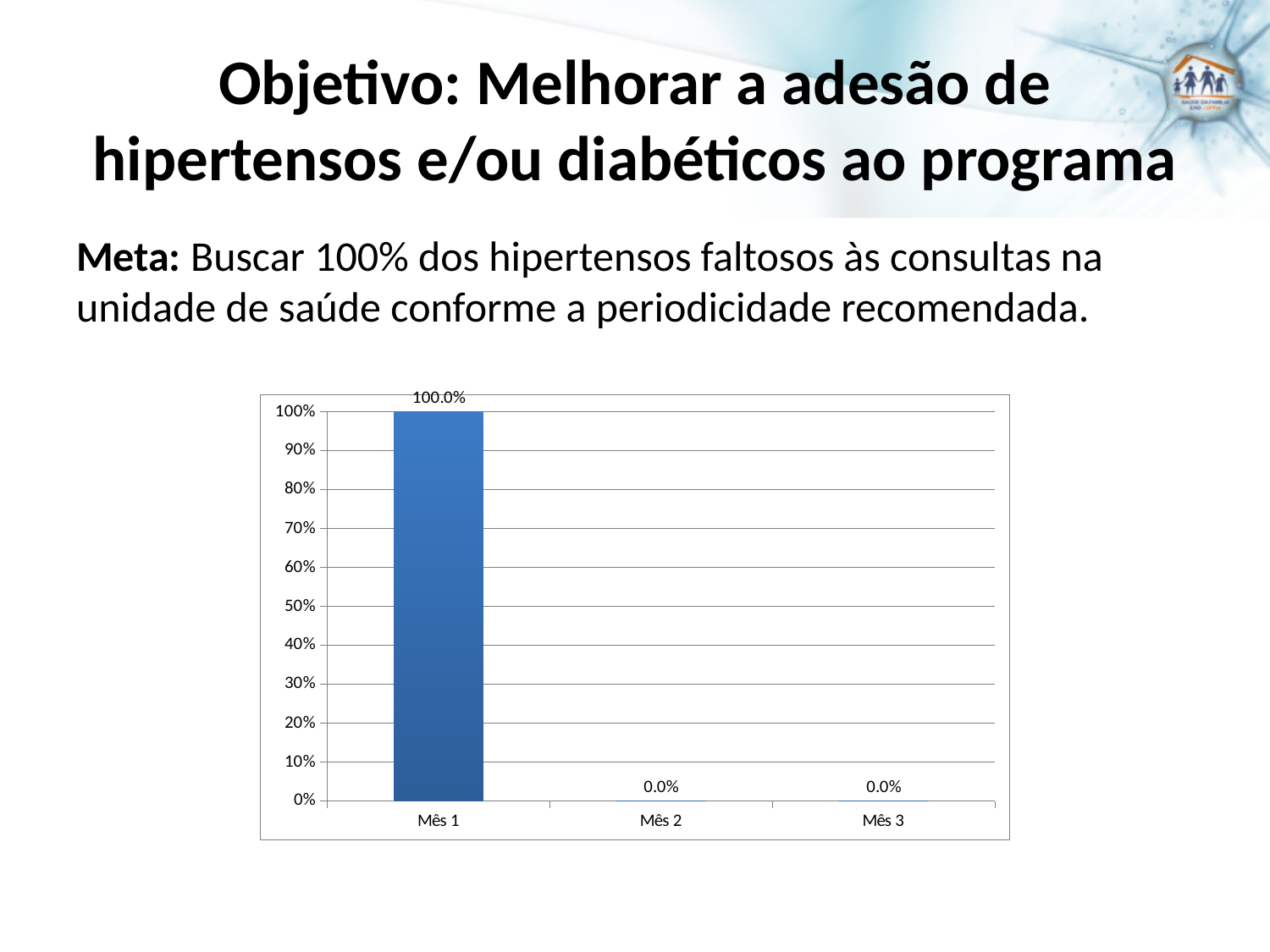
Do the values rise or fall from Mês 1 to Mês 3? fall Is the value for Mês 1 greater or less than 50%? greater What kind of chart is shown on the slide? bar chart What is the highest value shown on the y axis? 100% What is the value for Mês 1? 100.0% What is the difference between the values for Mês 1 and Mês 2? 100.0% What is the value for Mês 2? 0.0% How many categories are shown on the x axis? 3 Which is larger, the value for Mês 1 or the value for Mês 3? Mês 1 Which category has the highest value? Mês 1 What is the value for Mês 3? 0.0% What is the label of the first category on the x axis? Mês 1